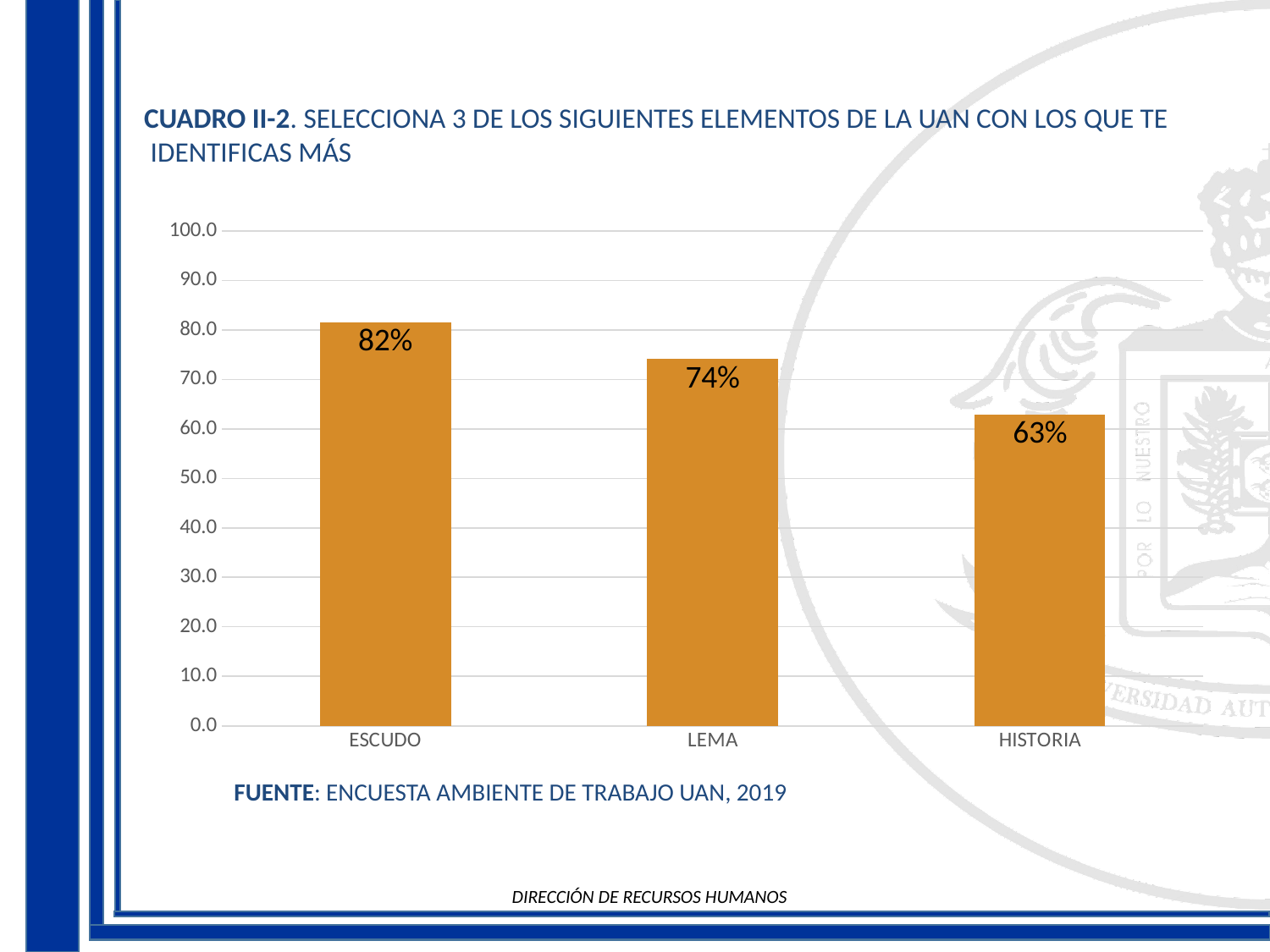
What is the value for ESCUDO? 82% What is the value for HISTORIA? 63% Which category has the highest value? ESCUDO How many categories are shown in the chart? 3 Do the values rise or fall from ESCUDO to HISTORIA along the x axis? fall What is the difference between the values for ESCUDO and HISTORIA? 19% What is the difference between the values for LEMA and HISTORIA? 11% Which is larger, the value for LEMA or the value for HISTORIA? LEMA What kind of chart is shown on the slide? bar chart Which category has the lowest value? HISTORIA Is the value for HISTORIA greater or less than 70.0? less What is the value for LEMA? 74%